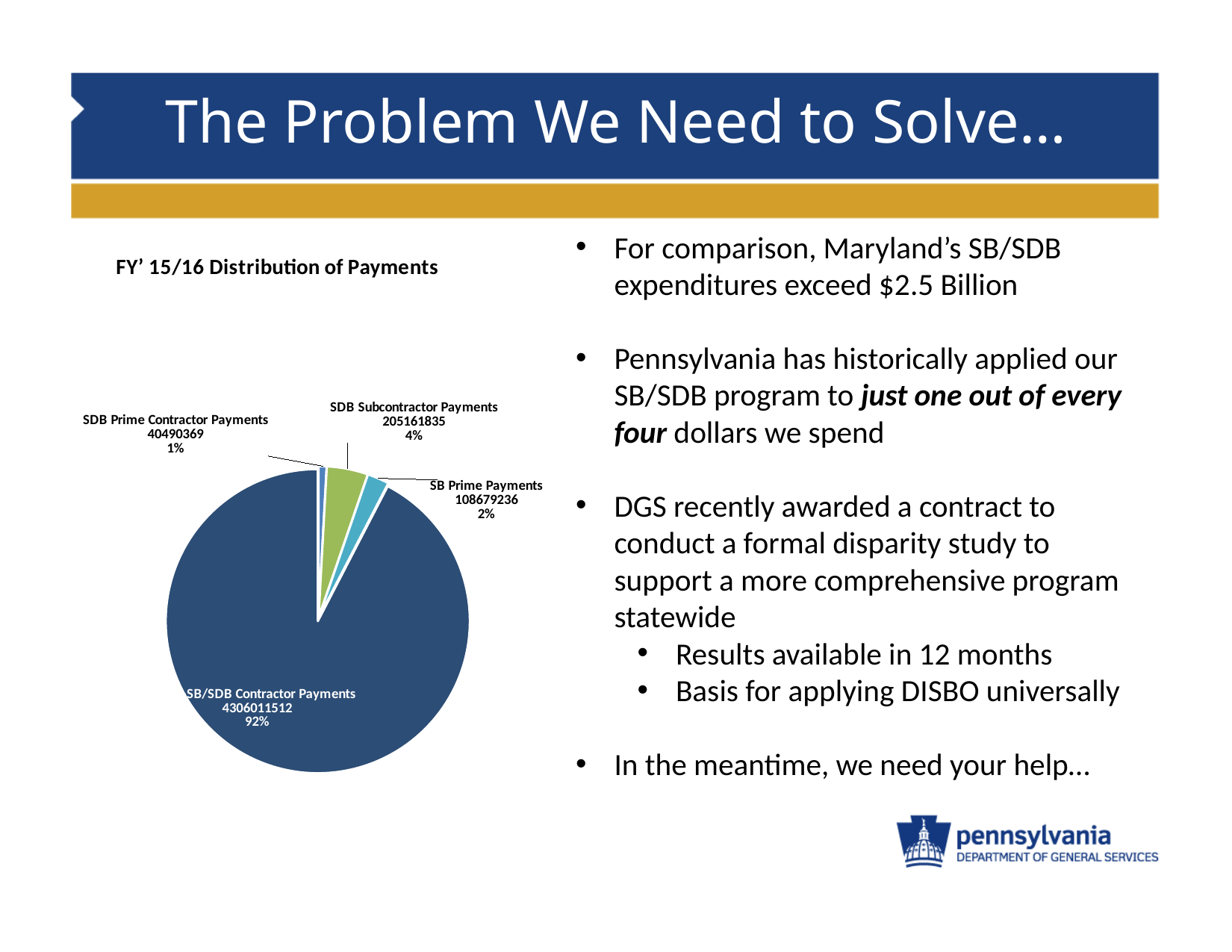
What share of the pie is SDB Prime Contractor Payments? 1% What is the value shown for SDB Subcontractor Payments? 205161835 What percentage is shown for the largest slice of the pie? 92% What share of the pie is SDB Subcontractor Payments? 4% Which is larger, SDB Subcontractor Payments or SB Prime Payments? SDB Subcontractor Payments What is the value shown for SDB Prime Contractor Payments? 40490369 What is the title of the chart? FY' 15/16 Distribution of Payments How many slices does the pie chart have? 4 Which slice of the pie is the smallest? SDB Prime Contractor Payments What is the difference between SDB Subcontractor Payments and SB Prime Payments? 96482599 What kind of chart is shown on the slide? pie chart What is the value shown for SB Prime Payments? 108679236